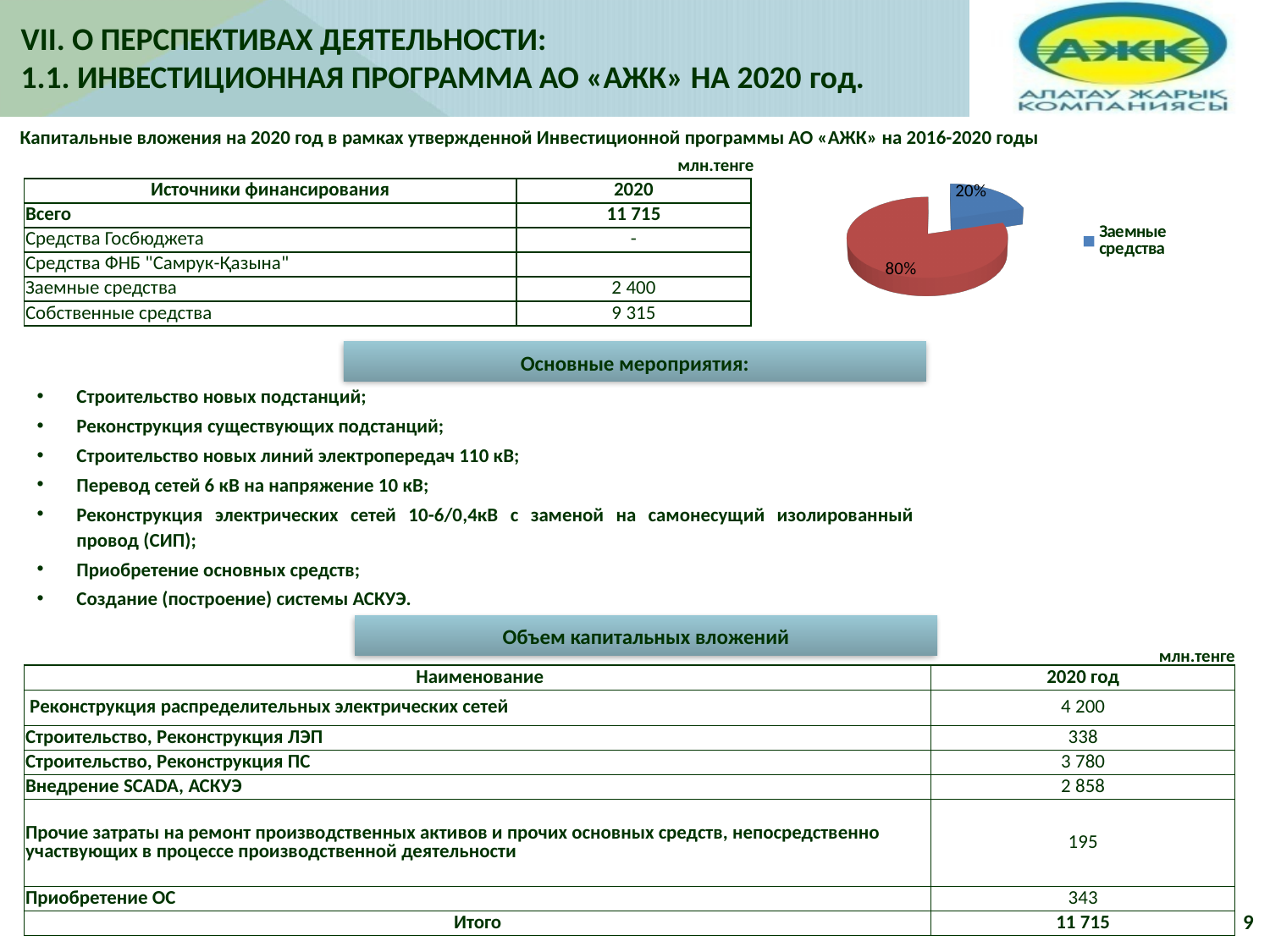
How many slices does the pie chart have? 2 Is the "Заемные средства" slice larger or smaller than the other slice of the pie? smaller What is the legend entry shown next to the pie chart? Заемные средства What colour is the "Заемные средства" slice in the pie chart? blue What percentage is printed on the largest slice of the pie chart? 80% What share of the pie does the slice labelled "Заемные средства" represent? 20% How many entries does the legend of the pie chart list? 1 What kind of chart is shown on the slide? pie chart What is the difference in percentage points between the two slices of the pie chart? 60 What percentage is printed on the smallest slice of the pie chart? 20%